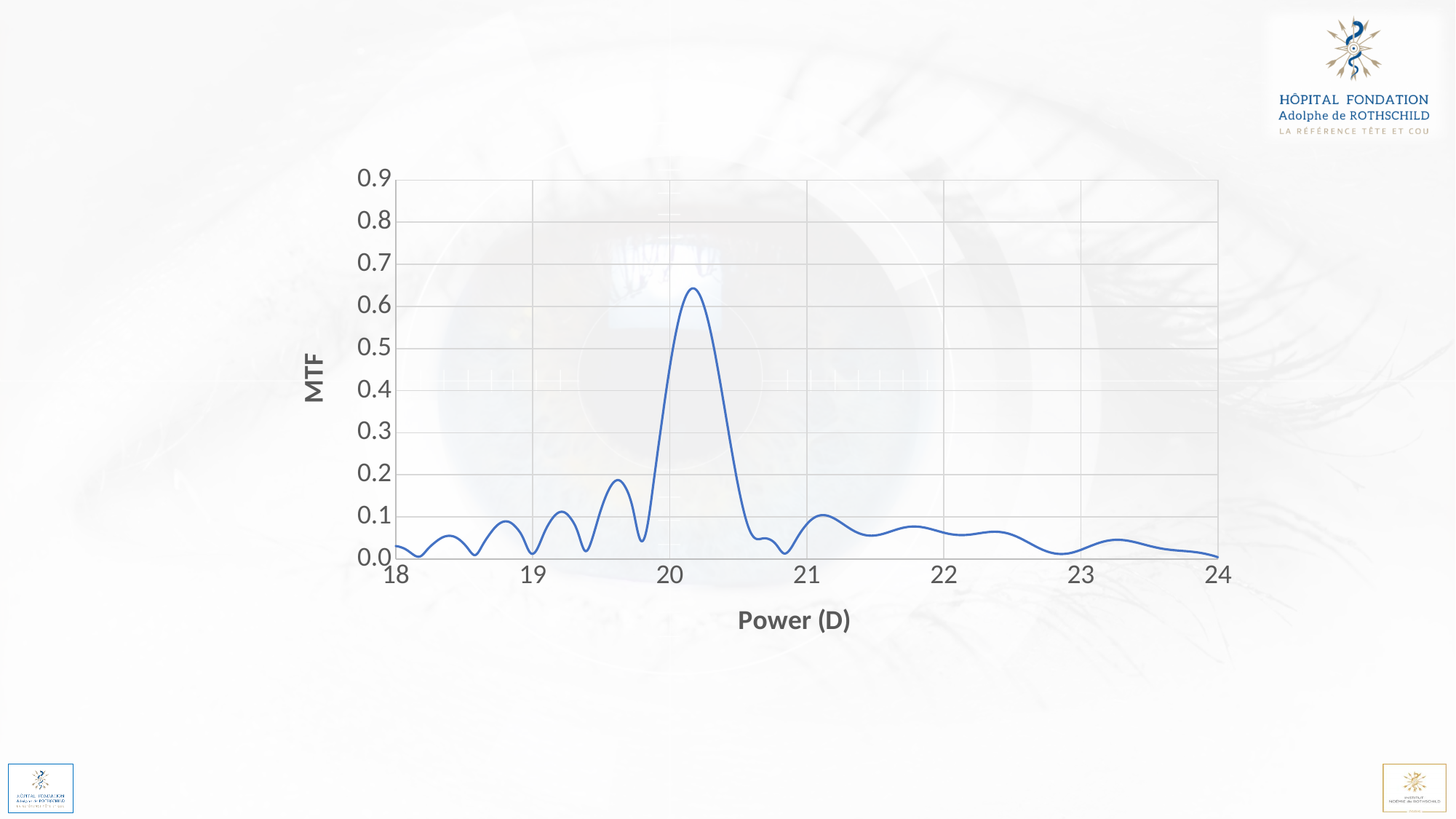
Is the peak MTF value of the curve greater or less than 0.7? less Does the curve rise or fall between a power of 20.2 D and 21 D? fall Is the MTF value at a power of 22 D greater or less than 0.2? less What kind of chart is shown on the slide? line chart Is the MTF value at a power of 24 D greater or less than 0.1? less What is the label of the y axis of the chart? MTF Between which two x-axis ticks does the curve reach its highest MTF value? 20 and 21 Which is larger, the MTF value at a power of 20 D or at a power of 22 D? 20 D What is the label of the x axis of the chart? Power (D)